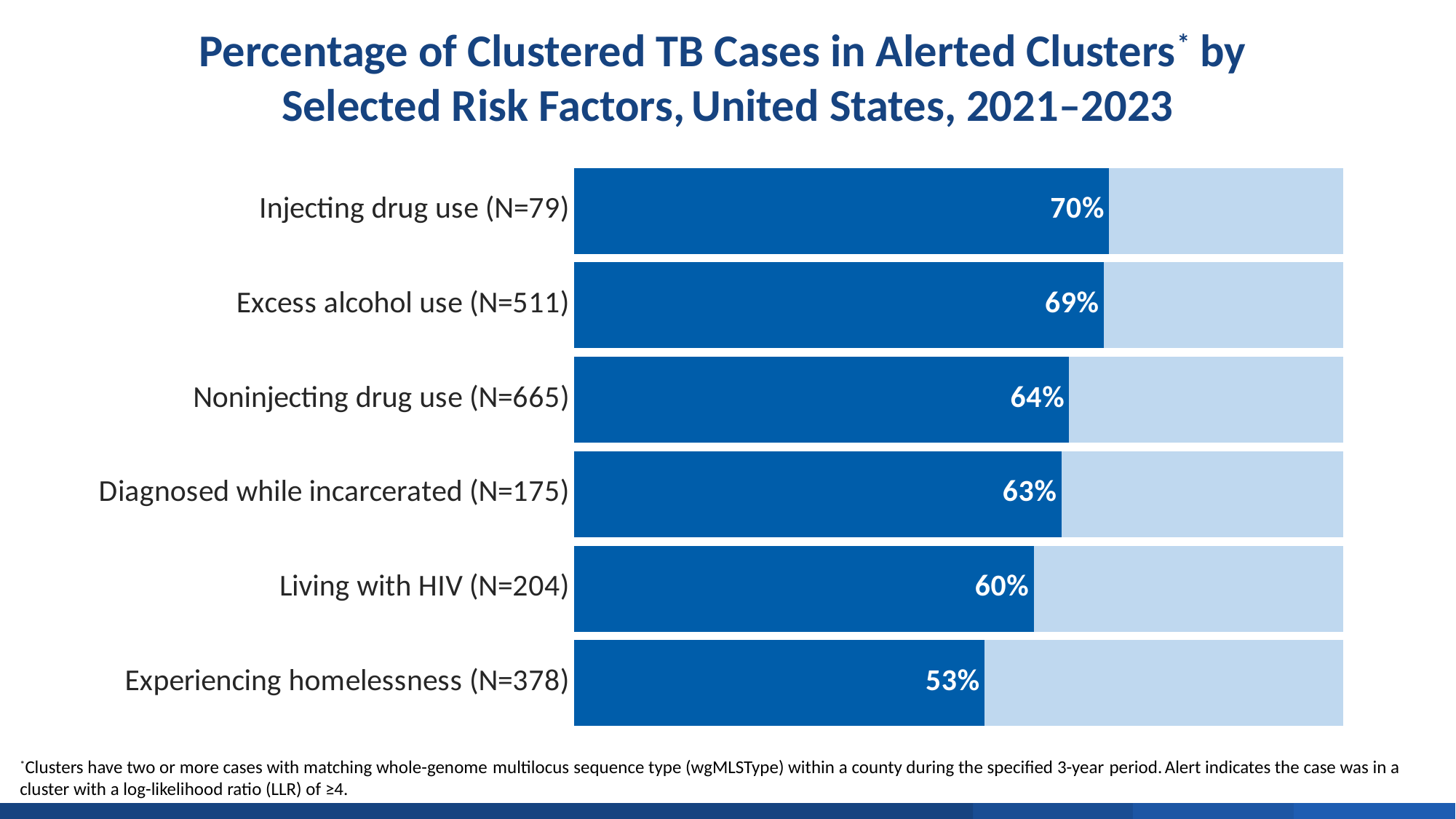
Which risk factor has the lowest percentage of clustered TB cases in alerted clusters? Experiencing homelessness Which risk factor has the highest percentage of clustered TB cases in alerted clusters? Injecting drug use What is the difference in percentage points between Injecting drug use and Experiencing homelessness? 17 What percentage is shown for Living with HIV? 60% What percentage is shown for Experiencing homelessness? 53% What percentage is shown for Diagnosed while incarcerated? 63% What percentage of clustered TB cases were in alerted clusters for Injecting drug use? 70% What is the N value shown for Noninjecting drug use? 665 Which has a higher percentage, Noninjecting drug use or Living with HIV? Noninjecting drug use What is the difference in percentage points between Excess alcohol use and Living with HIV? 9 How many risk factor categories are shown in the chart? 6 What kind of chart is shown on the slide? Bar chart